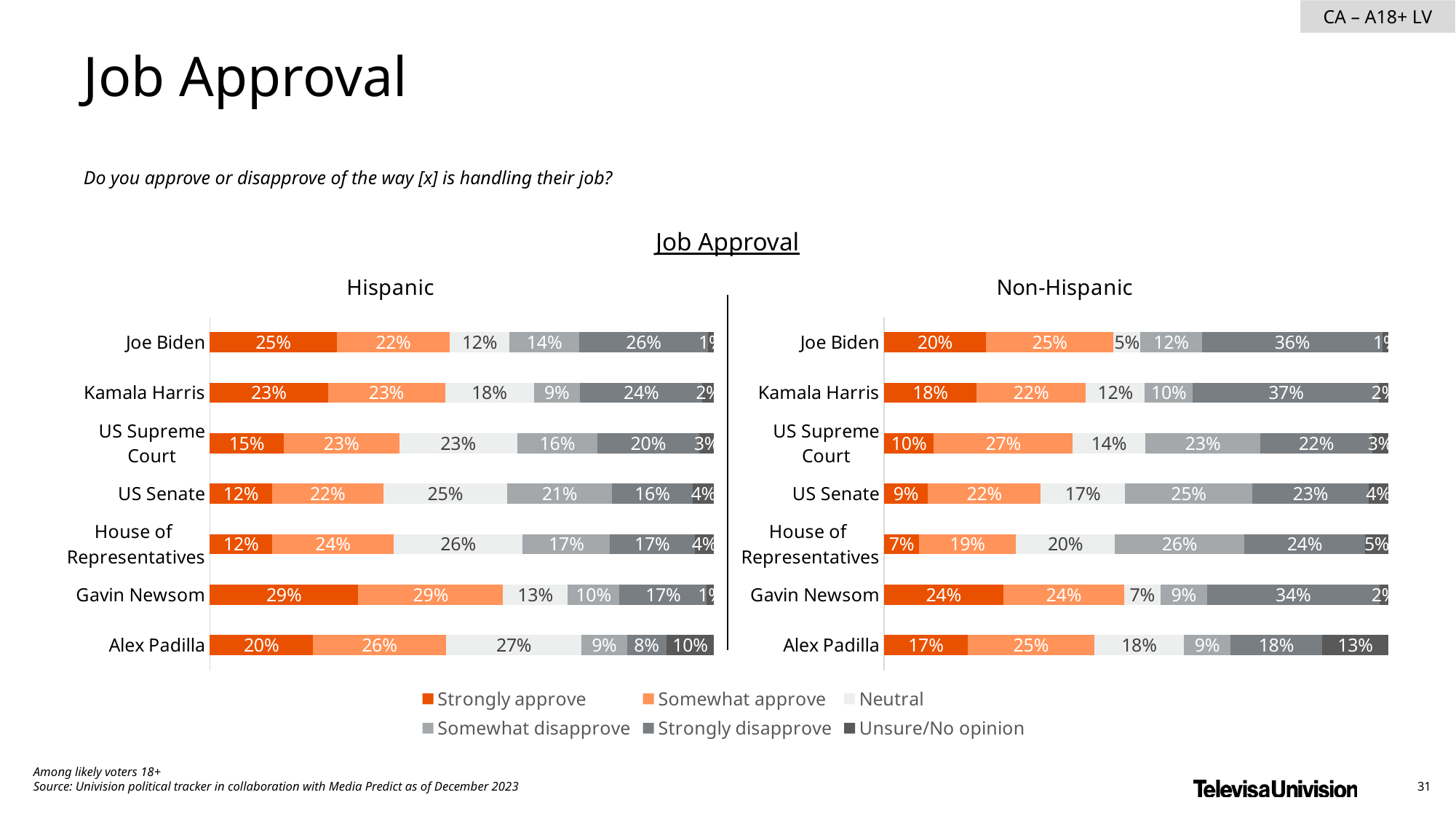
In the Hispanic chart, which category has the highest Strongly approve value? Gavin Newsom In the Non-Hispanic chart, what is the Strongly disapprove value for Kamala Harris? 37% What kind of chart is the Hispanic chart? Stacked bar chart In the Non-Hispanic chart, what is the Unsure/No opinion value for Alex Padilla? 13% What colour represents Strongly approve in the legend? Dark orange How many series does the legend list? 6 In the Non-Hispanic chart, which category has the lowest Strongly approve value? House of Representatives In the Hispanic chart, what is the difference between the Neutral values for Alex Padilla and Joe Biden? 15 percentage points In the Hispanic chart, which is larger: the Neutral value for US Senate or for Kamala Harris? US Senate In the Hispanic chart, what is the Somewhat disapprove value for US Senate? 21% In the Hispanic chart, what is the Strongly approve value for Gavin Newsom? 29% How many categories are shown in the Non-Hispanic chart? 7